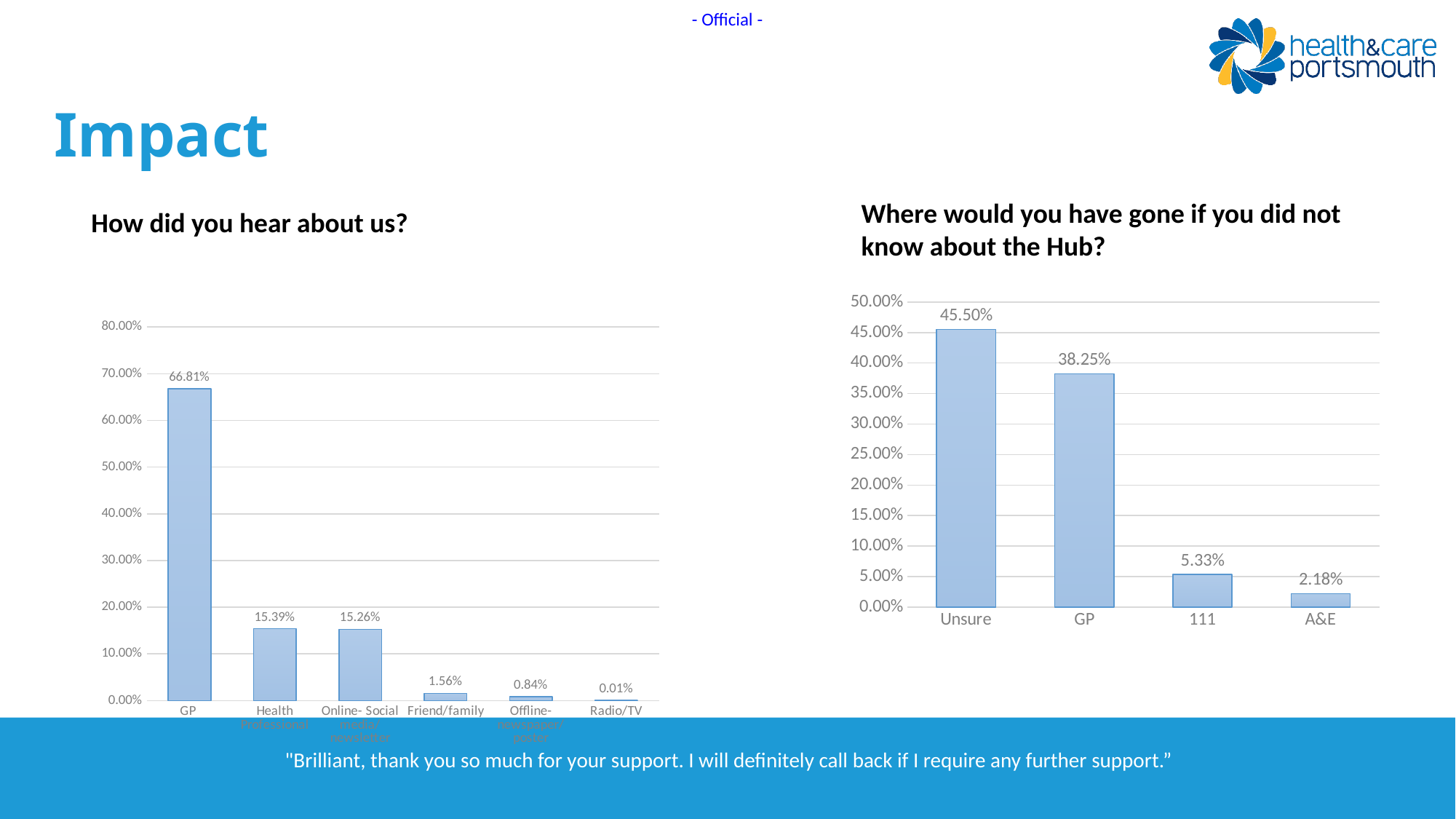
What type of chart is the 'Where would you have gone if you did not know about the Hub?' chart? Bar chart In the 'Where would you have gone if you did not know about the Hub?' chart, which category has the highest value? Unsure In the 'How did you hear about us?' chart, which category has the lowest value? Radio/TV In the 'Where would you have gone if you did not know about the Hub?' chart, what is the value for 111? 5.33% In the 'How did you hear about us?' chart, is the value for GP greater or less than 60.00%? greater In the 'Where would you have gone if you did not know about the Hub?' chart, what is the value for Unsure? 45.50% In the 'Where would you have gone if you did not know about the Hub?' chart, which is larger, GP or A&E? GP In the 'How did you hear about us?' chart, what is the difference between the GP value and the Health Professional value? 51.42% In the 'How did you hear about us?' chart, how many categories are shown? 6 In the 'How did you hear about us?' chart, what is the value for GP? 66.81% In the 'How did you hear about us?' chart, what is the value for Friend/family? 1.56% In the 'Where would you have gone if you did not know about the Hub?' chart, what is the difference between Unsure and GP? 7.25%